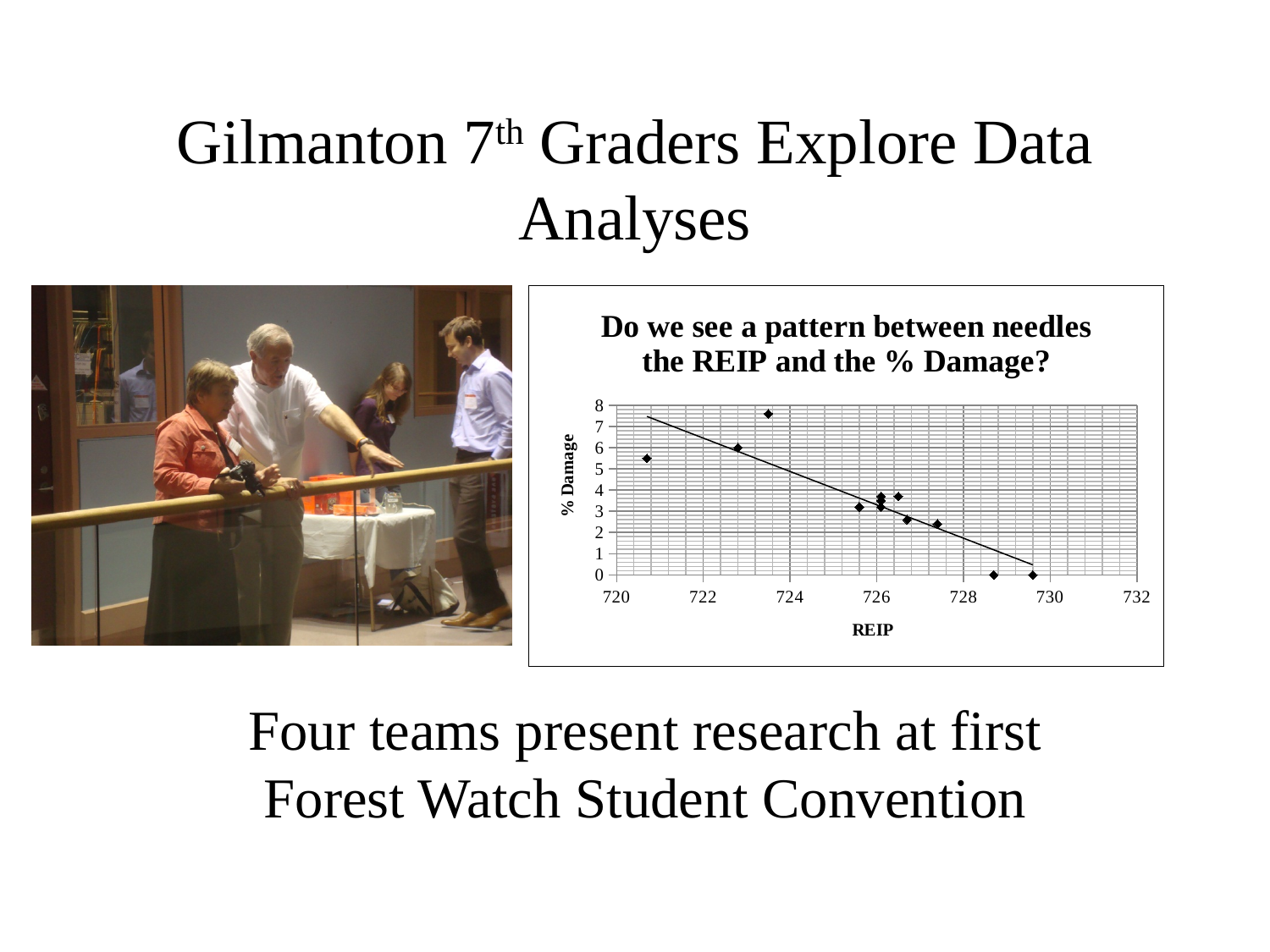
What kind of chart is shown on the slide? scatter chart Does the chart include a fitted trend line through the points? yes What is the lowest % Damage value plotted on the chart? 0 As REIP increases along the x axis, does % Damage generally rise or fall? fall What is the title of the chart? Do we see a pattern between needles the REIP and the % Damage? How many points are plotted at a % Damage of 0? 2 Is the % Damage for the point near REIP 725.5 greater or less than 5? less Which has the higher % Damage: the point near REIP 723.5 or the point near REIP 729.5? the point near REIP 723.5 Is the highest % Damage value plotted greater or less than 7? greater Is the % Damage for the point near REIP 723 greater or less than 5? greater